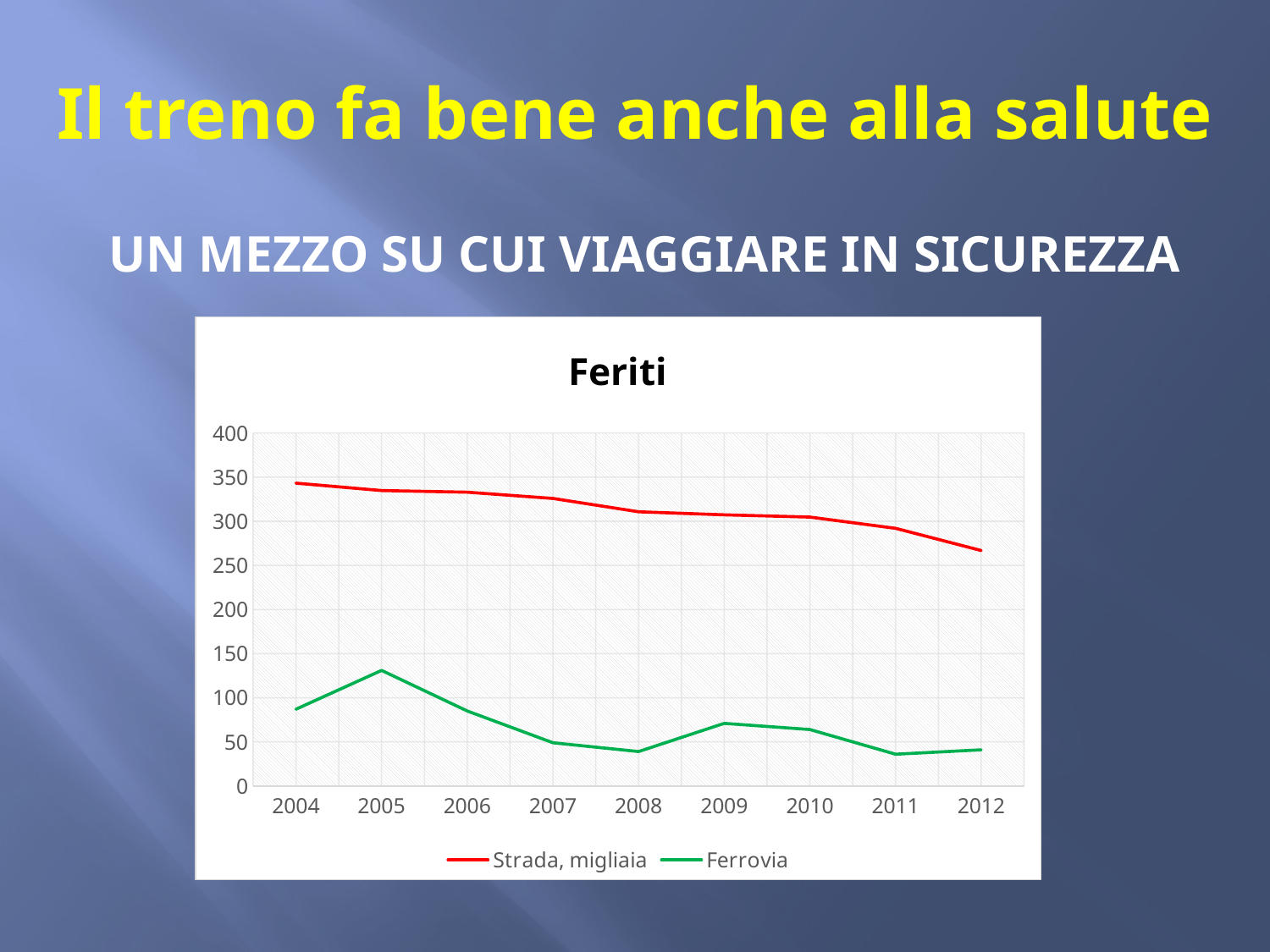
Is the value for Ferrovia in 2005 greater or less than 100? greater In which year does the Ferrovia series reach its highest value? 2005 Does the Strada, migliaia series rise or fall from 2004 to 2012? fall What is the title of the chart? Feriti How many series does the legend of the chart list? 2 What colour is the line for the Ferrovia series? green In which year does the Strada, migliaia series reach its highest value? 2004 In which year does the Strada, migliaia series reach its lowest value? 2012 Is the value for Strada, migliaia in 2012 greater or less than 300? less What kind of chart is shown on the slide? line chart How many years are plotted along the x axis of the chart? 9 In 2010, which series has the larger value, Strada, migliaia or Ferrovia? Strada, migliaia